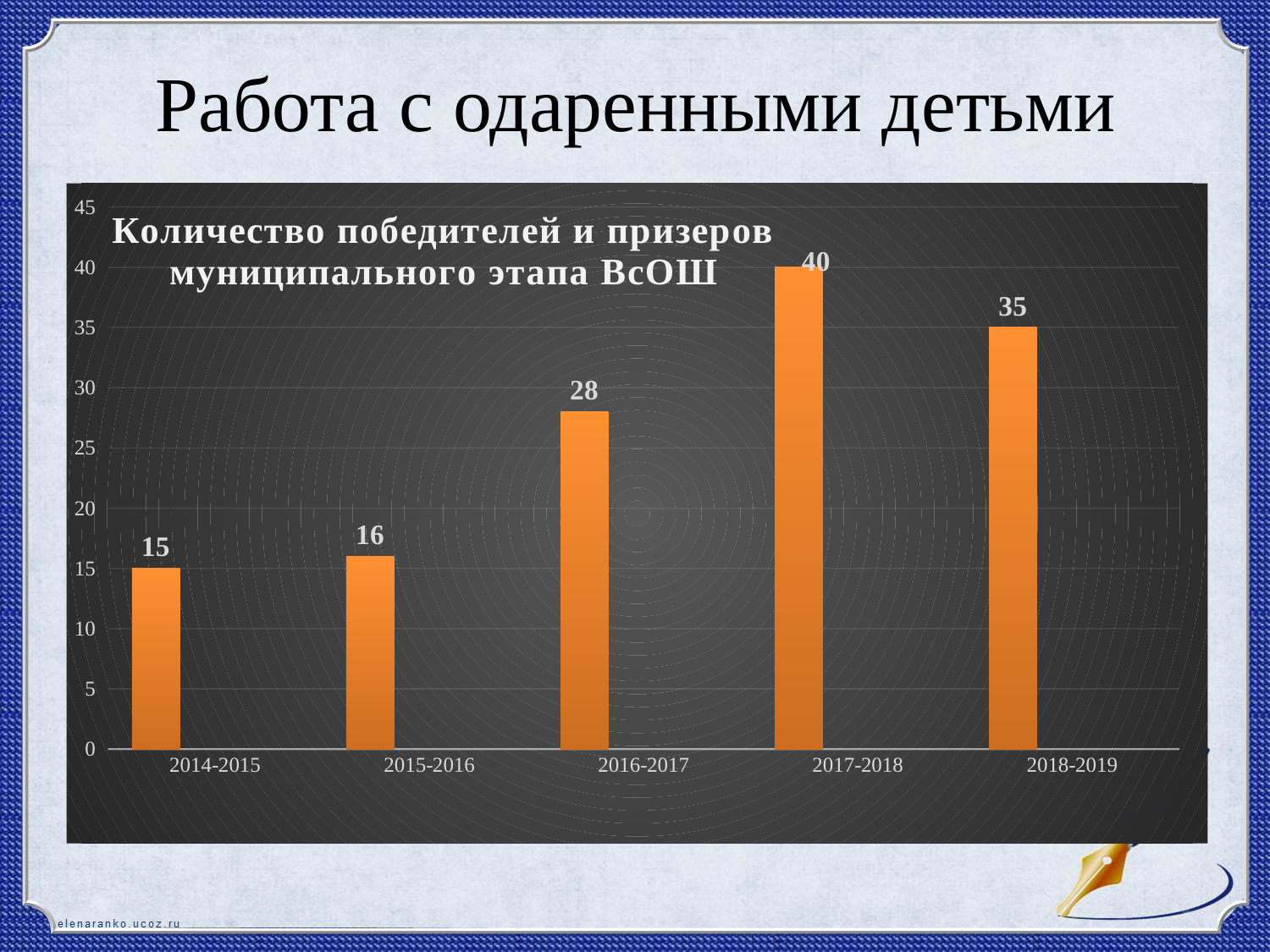
What is the difference between the values for 2017-2018 and 2018-2019? 5 What kind of chart is shown on the slide? bar chart What is the title of the chart? Количество победителей и призеров муниципального этапа ВсОШ What is the value for 2014-2015? 15 What is the difference between the values for 2016-2017 and 2015-2016? 12 How many years are shown on the x axis? 5 What is the value for 2017-2018? 40 Which year has the highest value? 2017-2018 What is the value for 2016-2017? 28 Which year has the lowest value? 2014-2015 Is the value for 2016-2017 greater or less than 25? greater Which is larger, the value for 2018-2019 or the value for 2016-2017? 2018-2019